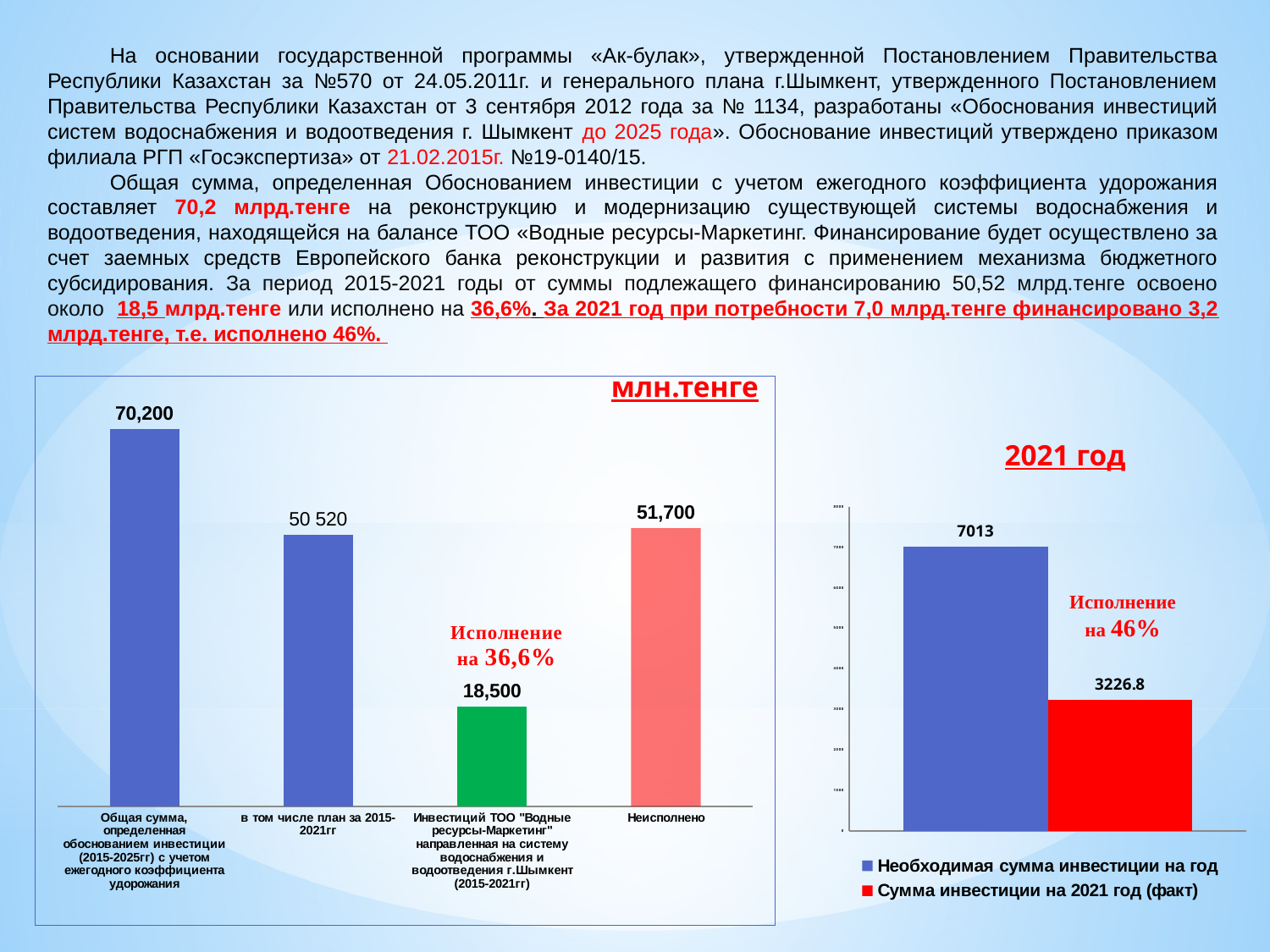
What type of chart is the right chart (2021 год)? Bar chart In the left chart (млн.тенге), what is the difference between the "Неисполнено" bar and the green bar (18,500)? 33,200 In the left chart (млн.тенге), what is the value of the bar "в том числе план за 2015-2021гг"? 50 520 In the left chart (млн.тенге), which category has the highest value? Общая сумма, определенная обоснованием инвестиции (2015-2025гг) с учетом ежегодного коэффициента удорожания In the left chart (млн.тенге), how many bars are plotted? 4 In the right chart (2021 год), what is the value of the red bar? 3226.8 In the left chart (млн.тенге), what is the value of the bar labelled "Неисполнено"? 51,700 In the left chart (млн.тенге), which category has the lowest value? Инвестиций ТОО "Водные ресурсы-Маркетинг" направленная на систему водоснабжения и водоотведения г.Шымкент (2015-2021гг) In the left chart (млн.тенге), what is the value of the green bar? 18,500 In the right chart (2021 год), what is the value of the blue bar? 7013 In the right chart (2021 год), which is larger: "Необходимая сумма инвестиции на год" or "Сумма инвестиции на 2021 год (факт)"? Необходимая сумма инвестиции на год In the right chart (2021 год), how many series does the legend list? 2